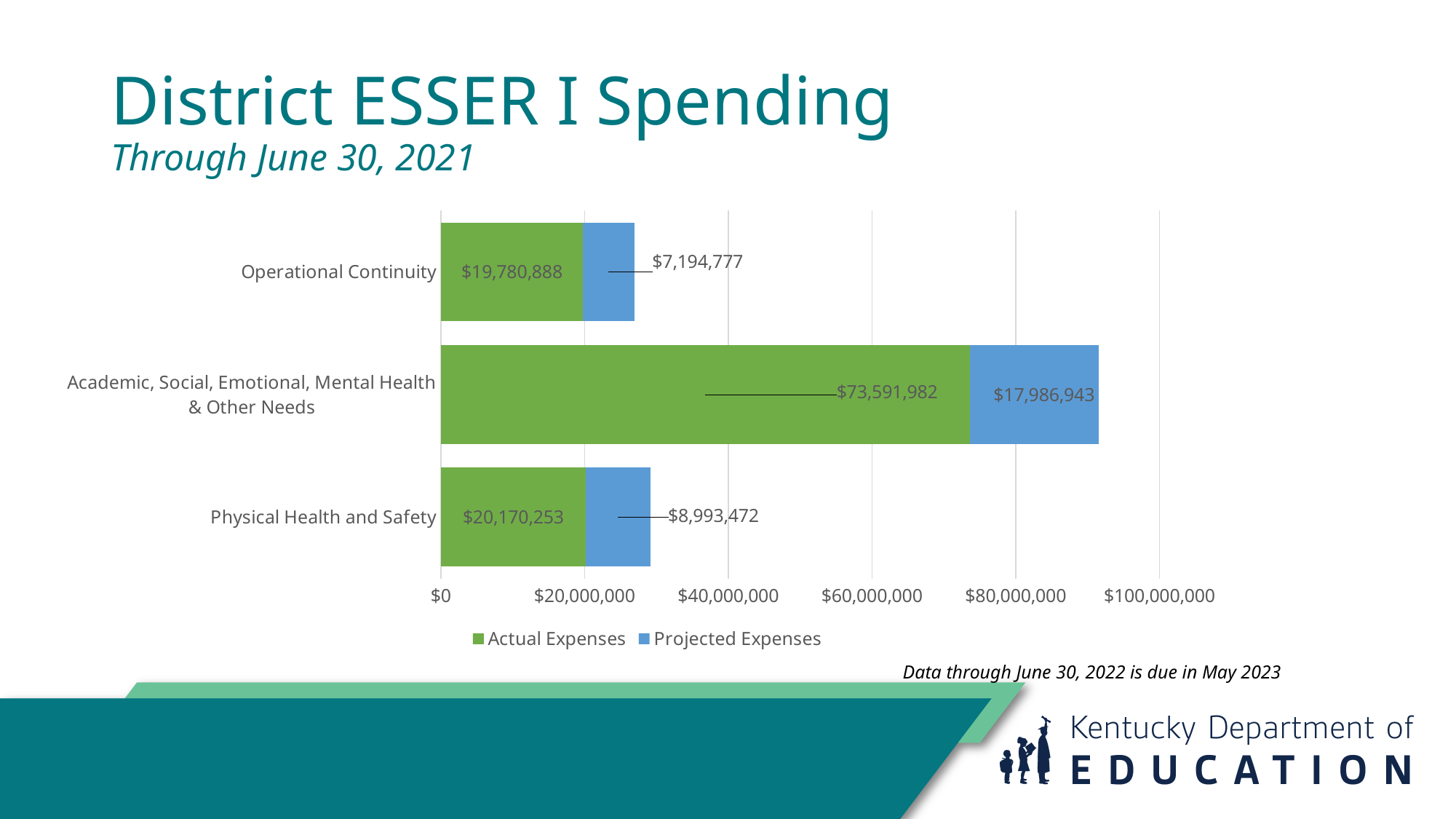
What is the Projected Expenses value for Academic, Social, Emotional, Mental Health & Other Needs? $17,986,943 Which category has the lowest Projected Expenses? Operational Continuity Which is larger: Projected Expenses for Physical Health and Safety or Projected Expenses for Operational Continuity? Physical Health and Safety What is the Actual Expenses value for Operational Continuity? $19,780,888 What is the total of Actual and Projected Expenses for Operational Continuity? $26,975,665 What is the difference between Projected Expenses for Physical Health and Safety and Projected Expenses for Operational Continuity? $1,798,695 How many series does the legend list? 2 How many categories are shown on the chart? 3 Is the Actual Expenses value for Academic, Social, Emotional, Mental Health & Other Needs greater or less than $60,000,000? greater Which category has the highest Actual Expenses? Academic, Social, Emotional, Mental Health & Other Needs What is the Projected Expenses value for Physical Health and Safety? $8,993,472 What kind of chart is shown on the slide? Stacked bar chart